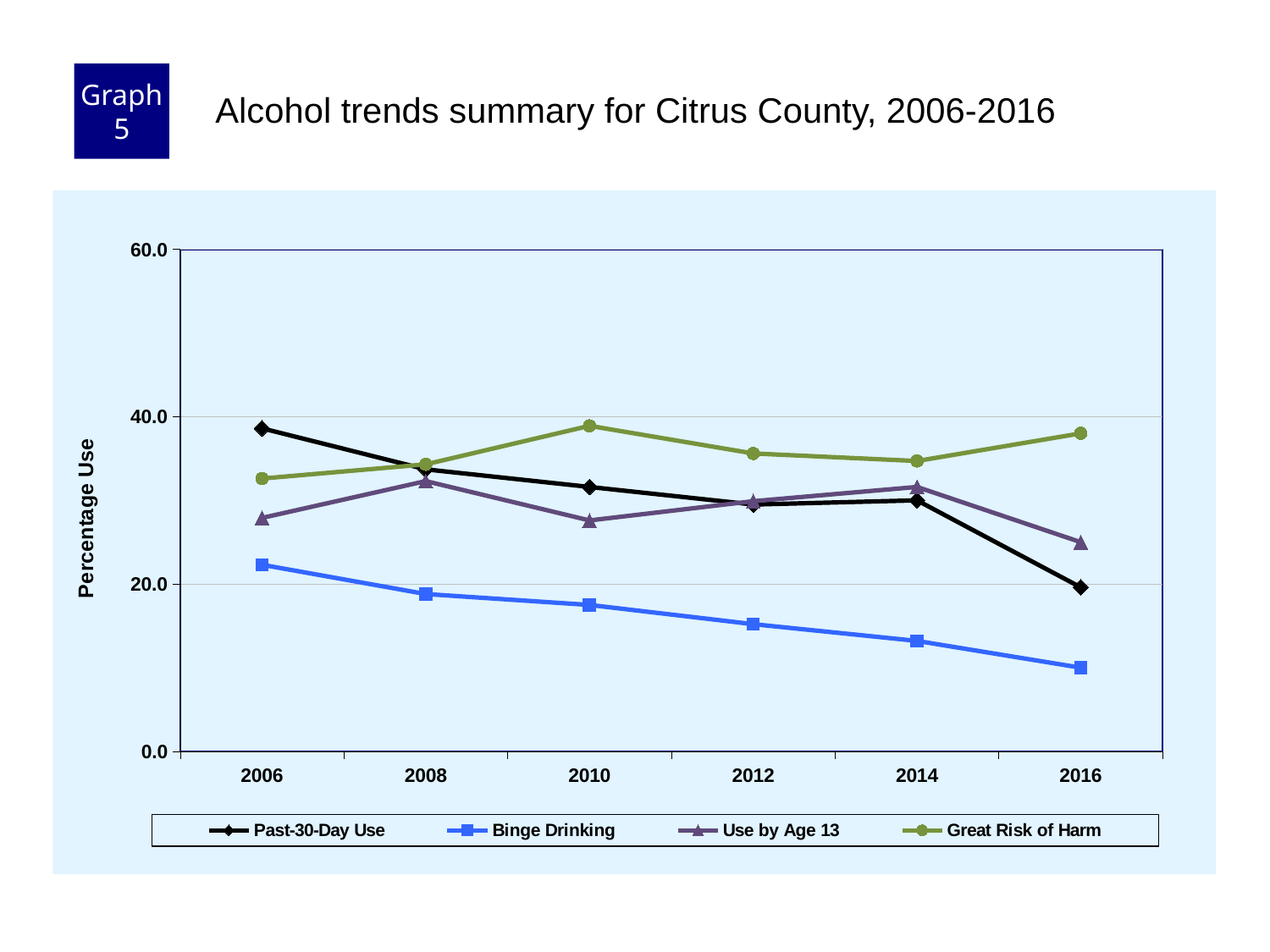
Which series has the lowest value in 2016? Binge Drinking Which series has the highest value in 2016? Great Risk of Harm In which year is the Binge Drinking value lowest? 2016 In which year is the Past-30-Day Use value highest? 2006 Is the Binge Drinking value for 2016 greater or less than 20.0? less How many series does the legend list? 4 Is the Use by Age 13 value for 2016 greater or less than 20.0? greater How many years are plotted along the x axis? 6 What is the label on the y axis? Percentage Use What kind of chart is shown on the slide? Line chart In 2006, which is larger: Past-30-Day Use or Binge Drinking? Past-30-Day Use Does the Binge Drinking line rise or fall from 2006 to 2016? Falls